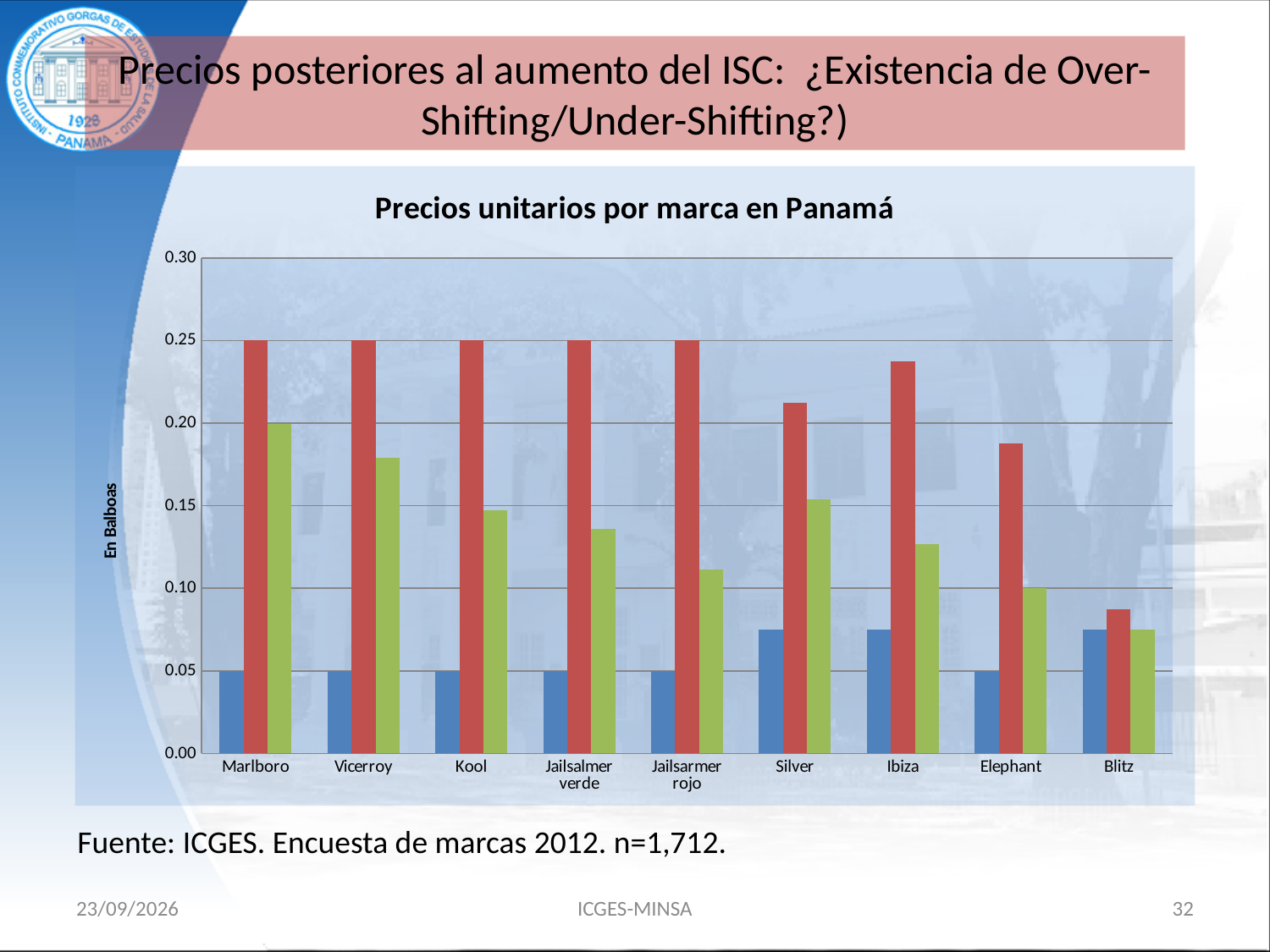
Is the value of the red bar for Blitz greater or less than 0.10? less Is the value of the red bar for Silver greater or less than 0.20? greater Which is larger, the red bar for Ibiza or the red bar for Elephant? Ibiza What type of chart is shown on the slide? Bar chart Which brand has the highest green bar? Marlboro What is the title of the chart? Precios unitarios por marca en Panamá What is the value of the red bar for Marlboro? 0.25 How many brands (categories) are shown on the x axis of the chart? 9 What is the label on the vertical axis of the chart? En Balboas Which brand has the lowest red bar? Blitz What is the value of the green bar for Marlboro? 0.20 What is the value of the blue bar for Marlboro? 0.05